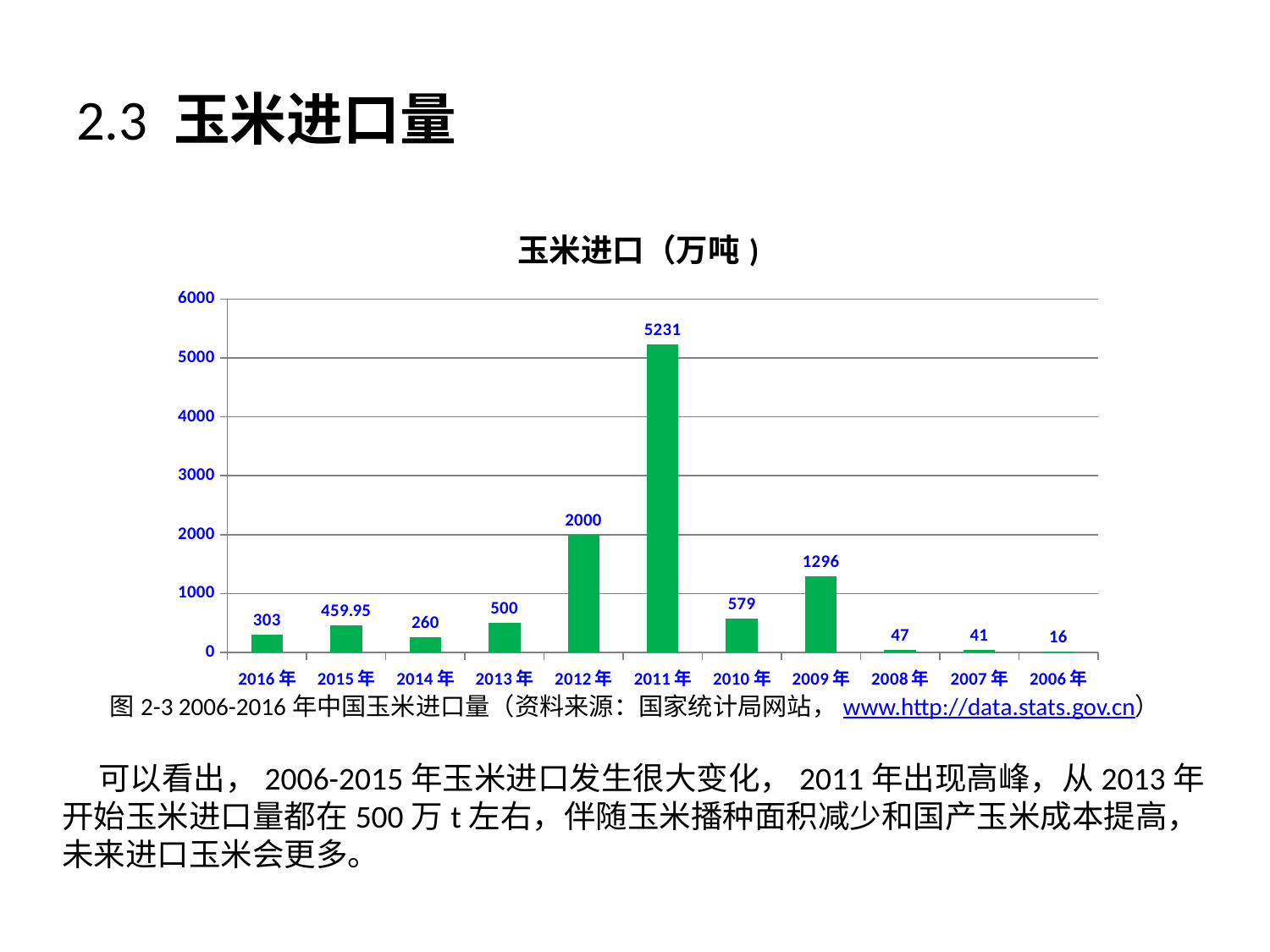
Is the value for 2012年 in the 玉米进口（万吨） chart greater or less than 1000? greater How many years are shown on the x axis of the 玉米进口（万吨） chart? 11 Which year has the lowest value in the 玉米进口（万吨） chart? 2006年 Which year has the highest value in the 玉米进口（万吨） chart? 2011年 What is the value for 2006年 in the 玉米进口（万吨） chart? 16 What is the title of the chart on the slide? 玉米进口（万吨） What kind of chart is the 玉米进口（万吨） chart? bar chart Which is larger in the 玉米进口（万吨） chart, the value for 2009年 or the value for 2010年? 2009年 What is the value for 2015年 in the 玉米进口（万吨） chart? 459.95 What colour are the bars in the 玉米进口（万吨） chart? green What is the difference between the values for 2011年 and 2012年 in the 玉米进口（万吨） chart? 3231 What is the value for 2011年 in the 玉米进口（万吨） chart? 5231